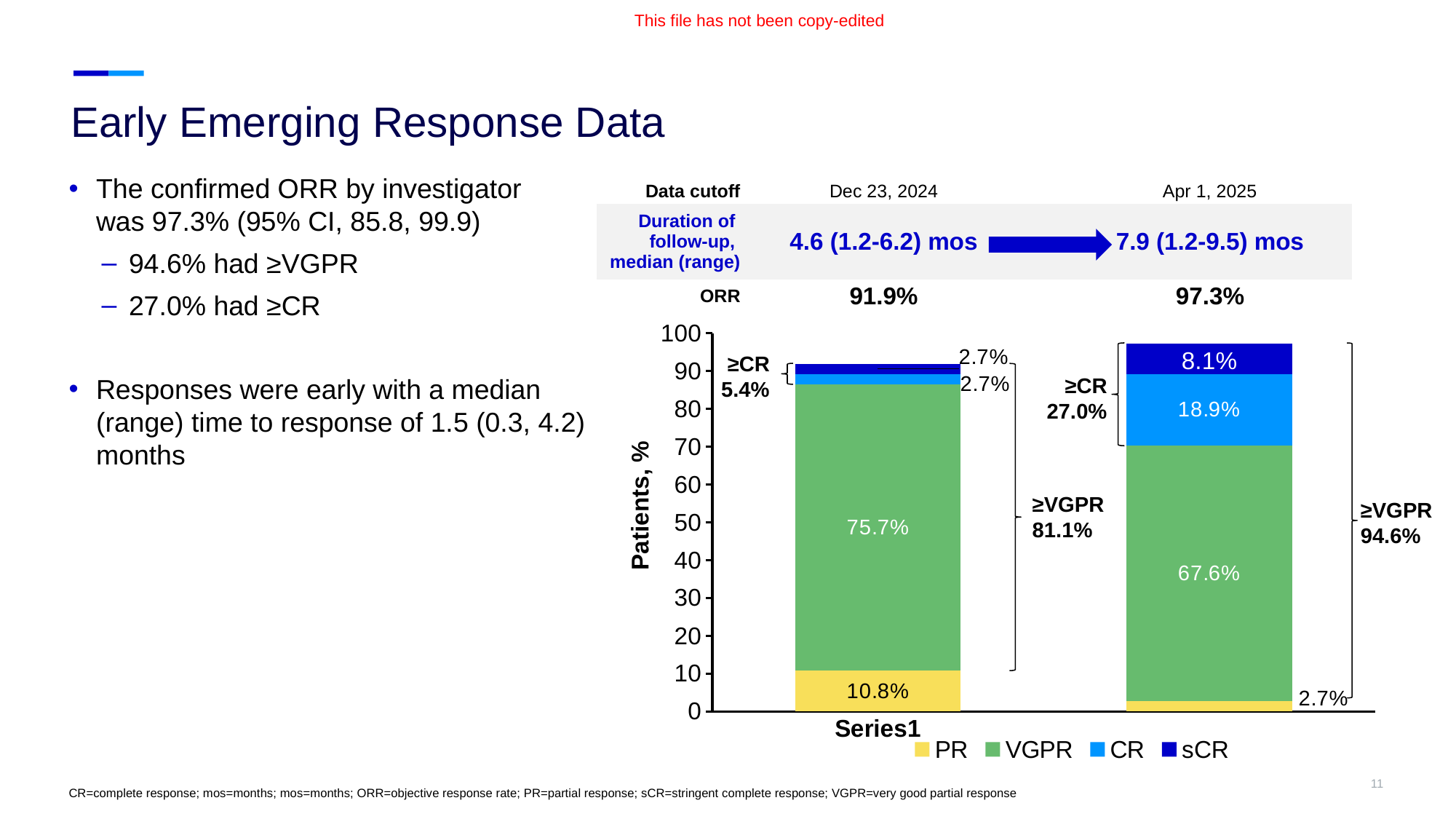
What is the VGPR value in the left bar (Dec 23, 2024 data cutoff)? 75.7% What is the difference between the VGPR value in the left bar and the VGPR value in the right bar? 8.1% What type of chart is shown on the slide? Stacked bar chart How many bars are plotted in the chart? 2 What is the sCR value in the right bar (Apr 1, 2025 data cutoff)? 8.1% What is the CR value in the right bar (Apr 1, 2025 data cutoff)? 18.9% What is the total of the stacked bar for the Apr 1, 2025 data cutoff? 97.3% How many series does the chart legend list? 4 Which is larger: the CR value in the left bar or the CR value in the right bar? Right bar (Apr 1, 2025) What is the label on the vertical axis of the chart? Patients, % Which segment is the largest in the right bar (Apr 1, 2025 data cutoff)? VGPR What is the PR value in the left bar (Dec 23, 2024 data cutoff)? 10.8%